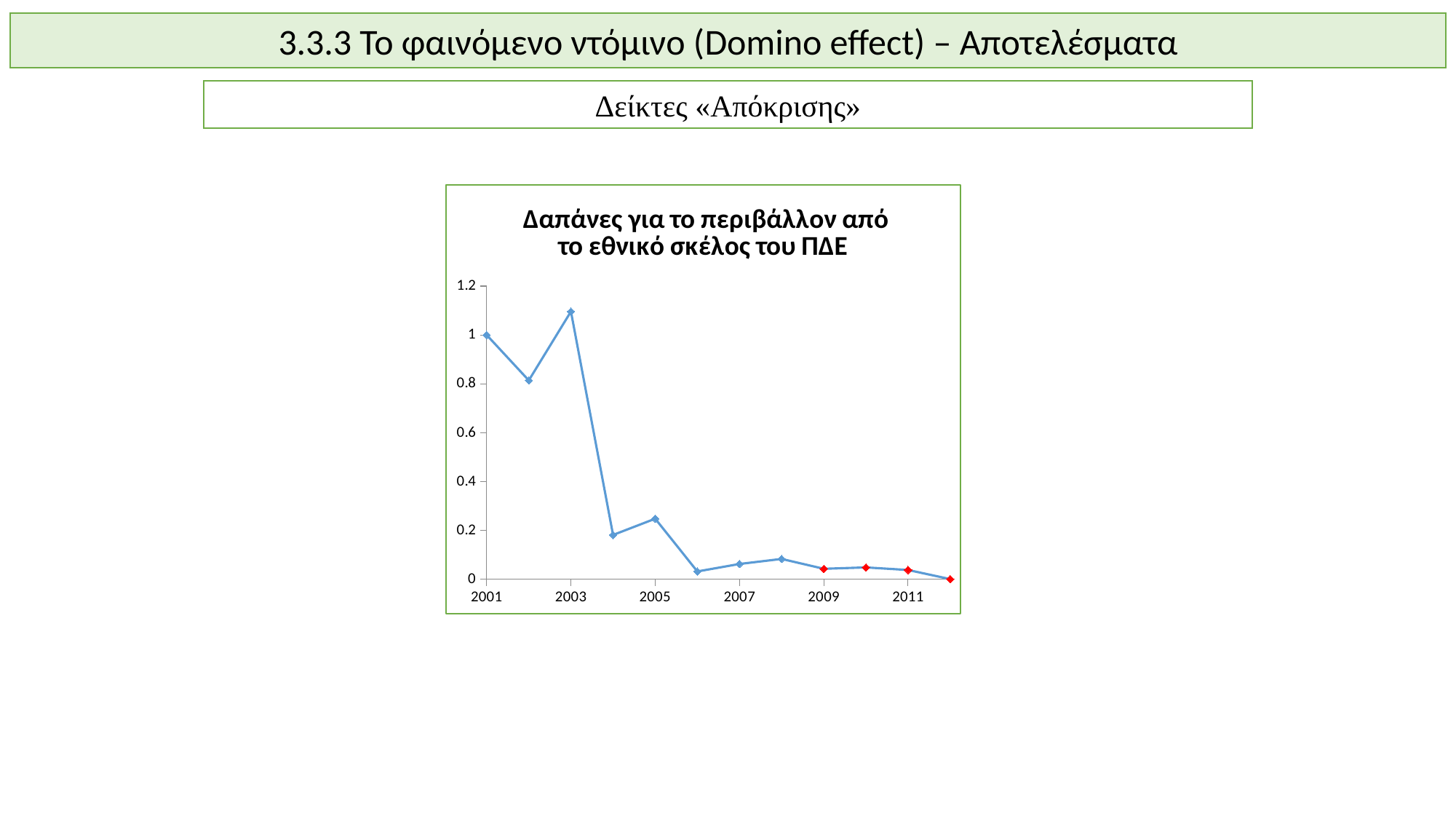
Is the value for 2002 greater or less than 1? less In which year is the value lowest? 2012 What is the title of the chart? Δαπάνες για το περιβάλλον από το εθνικό σκέλος του ΠΔΕ In which year is the value highest? 2003 Is the value for 2003 greater or less than 1? greater Do the values generally rise or fall from 2001 to 2012? fall Which years are marked with red markers instead of blue? 2009, 2010, 2011, 2012 Which year has the larger value, 2004 or 2005? 2005 What is the value for 2001? 1 What kind of chart is shown on the slide? line chart How many data points are plotted on the line? 12